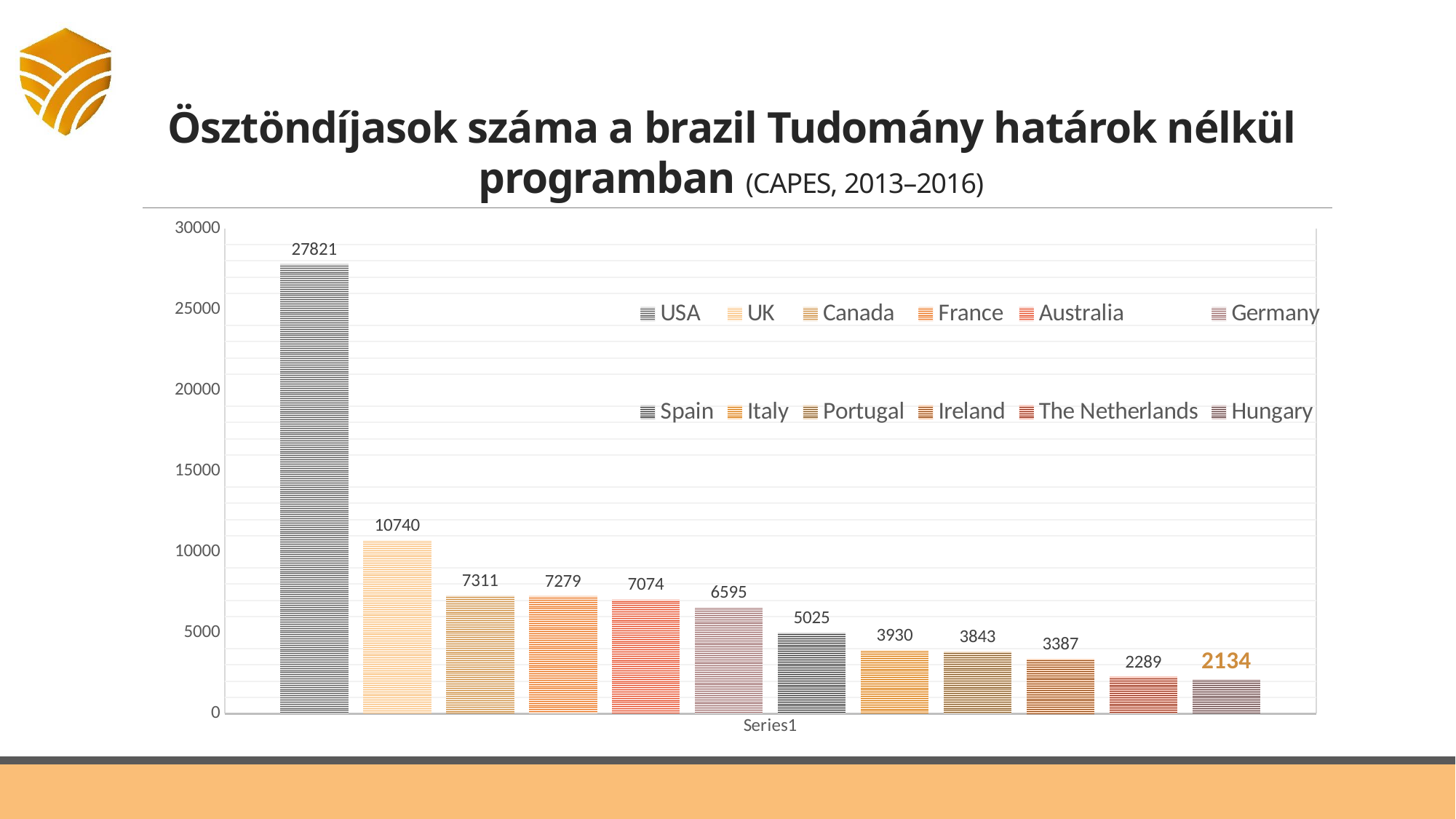
What kind of chart is shown on the slide? Bar chart What is the difference between the values for Spain and Italy? 1095 Which country has the highest value? USA What is the value for Germany? 6595 What is the value for USA? 27821 What is the difference between the values for USA and UK? 17081 How many series does the legend list? 12 Which country has the lowest value? Hungary What is the value for The Netherlands? 2289 What is the value for Hungary? 2134 Which is larger, the value for Canada or the value for Spain? Canada What is the label shown on the x axis below the bars? Series1